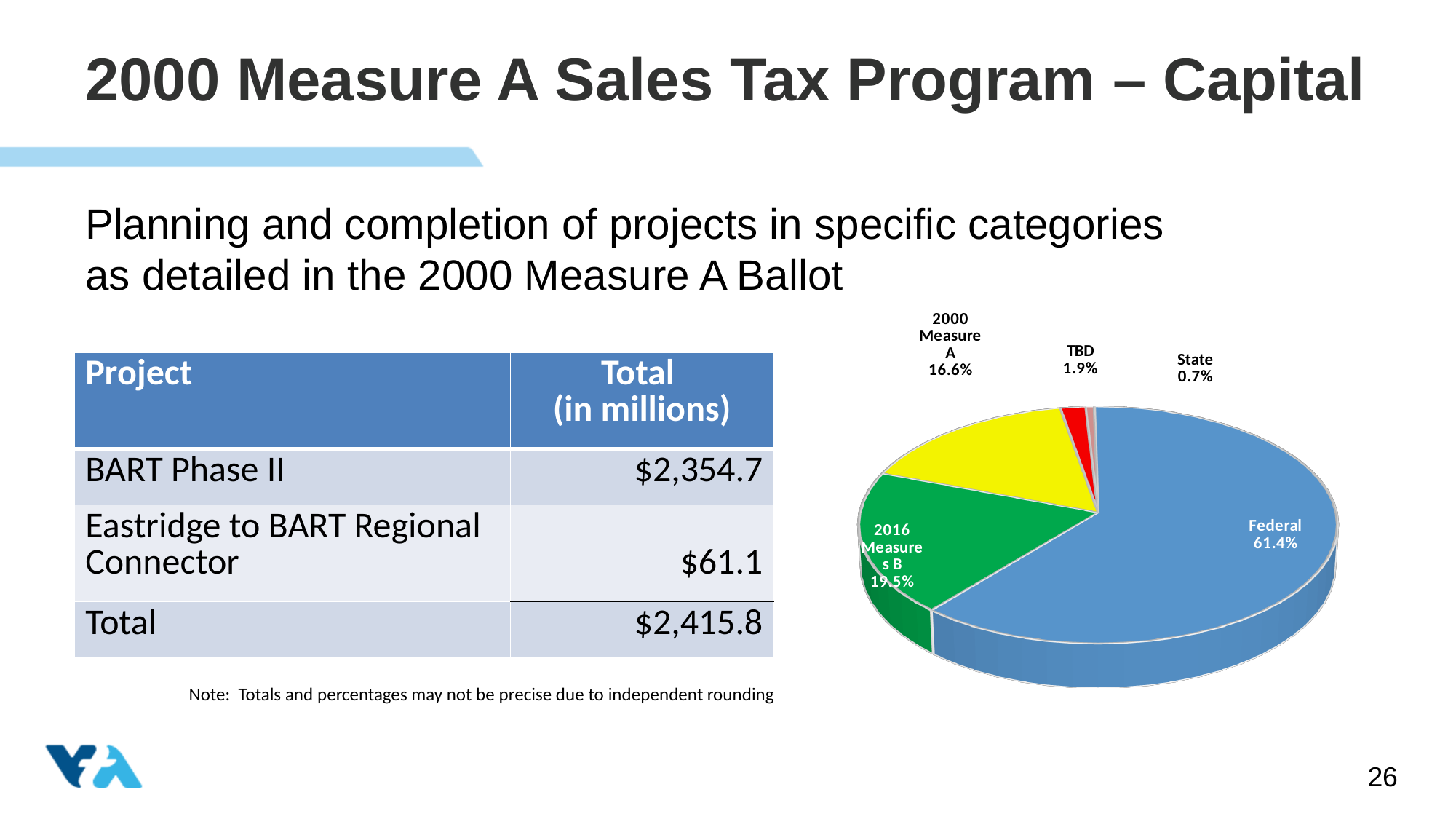
What share of the pie does 2000 Measure A represent? 16.6% Which slice of the pie chart is the smallest? State What kind of chart is shown on the slide? Pie chart How many slices does the pie chart have? 5 What share of the pie does 2016 Measure B represent? 19.5% Which slice of the pie chart is the largest? Federal What is the difference in percentage points between Federal and 2016 Measure B? 41.9 What percentage is shown for TBD in the pie chart? 1.9% What share of the pie does Federal represent? 61.4% Which is larger in the pie chart, 2016 Measure B or 2000 Measure A? 2016 Measure B What colour is the Federal slice of the pie chart? Blue What percentage is shown for State in the pie chart? 0.7%